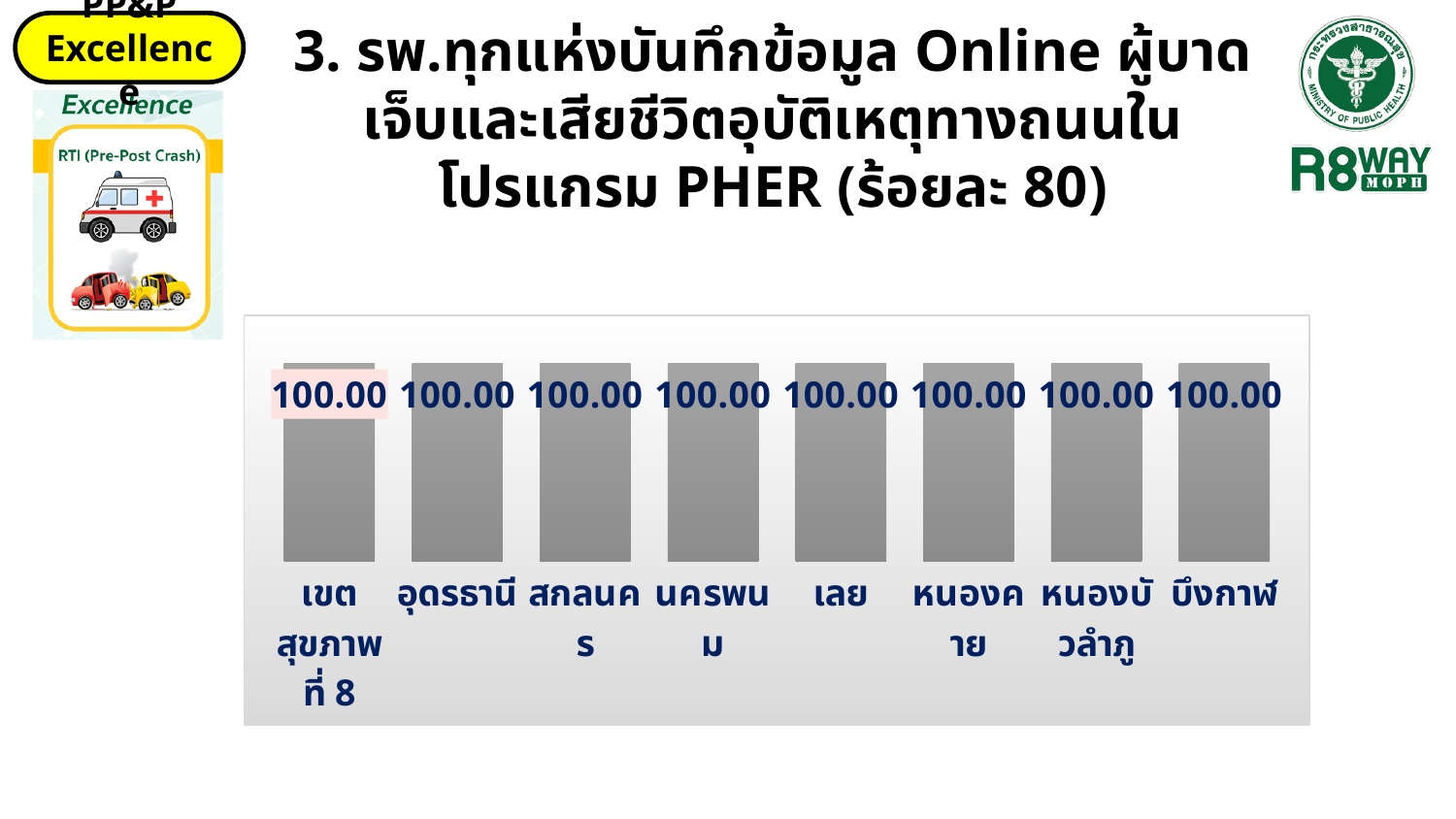
What is the value for บึงกาฬ? 100.00 What kind of chart is shown on the slide? bar chart What is the value for อุดรธานี? 100.00 Do the values rise, fall, or stay the same across the categories? stay the same What is the value for เขตสุขภาพที่ 8? 100.00 Which category is shown first (leftmost) in the chart? เขตสุขภาพที่ 8 What is the value for หนองบัวลำภู? 100.00 How many categories are shown in the chart? 8 What is the value for เลย? 100.00 What is the value for หนองคาย? 100.00 What is the difference between the values for สกลนคร and นครพนม? 0.00